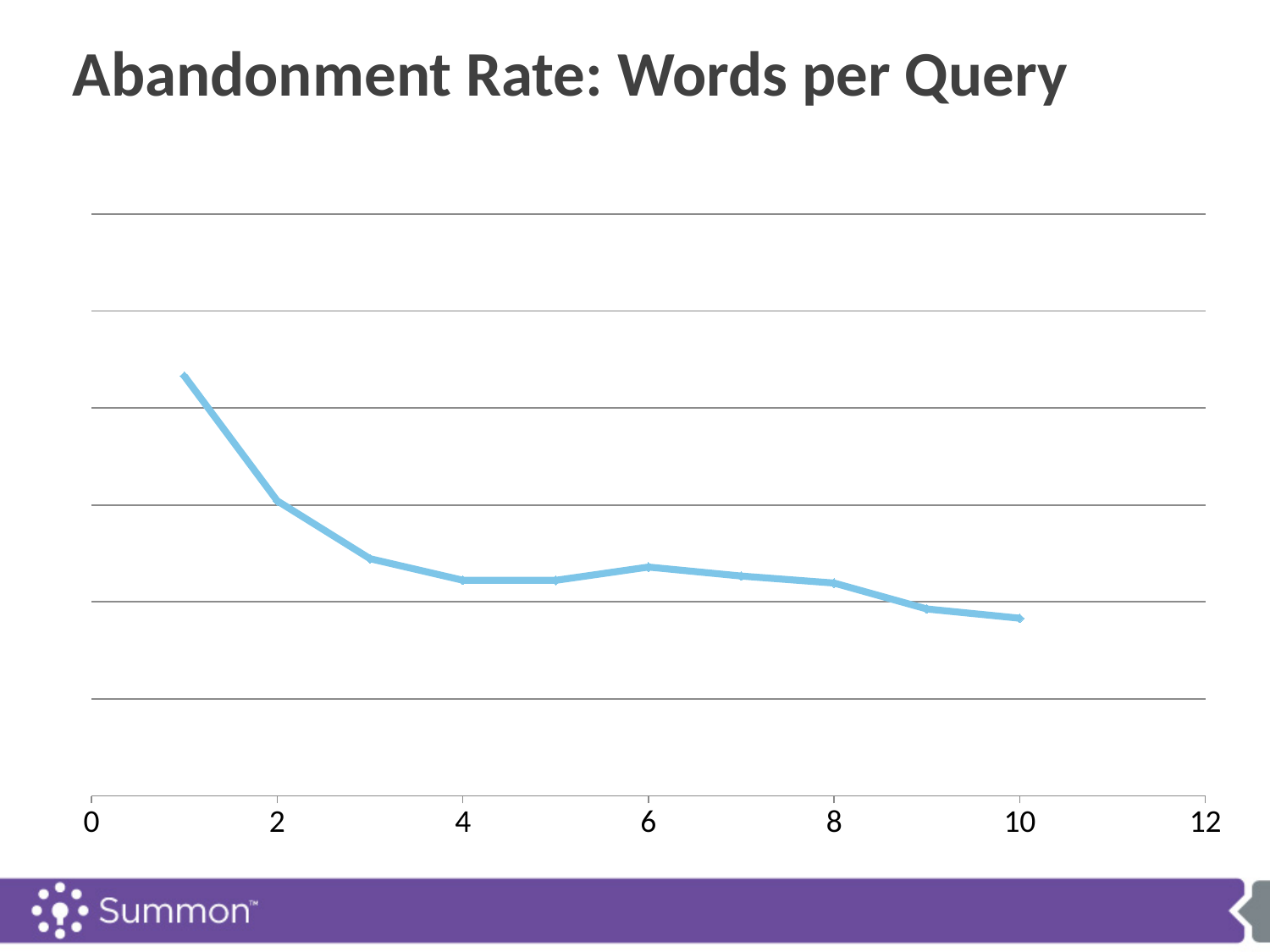
What is the largest value labelled on the x axis? 12 At which words-per-query value is the abandonment rate highest? 1 Which has the higher abandonment rate: 1 word per query or 2 words per query? 1 word per query Which has the higher abandonment rate: 6 words per query or 9 words per query? 6 words per query How many data points are plotted on the line? 10 At which words-per-query value is the abandonment rate lowest? 10 What is the title of the chart? Abandonment Rate: Words per Query Which has the higher abandonment rate: 3 words per query or 4 words per query? 3 words per query Does the abandonment rate generally rise or fall as words per query increases along the x axis? fall What kind of chart is shown on the slide? line chart